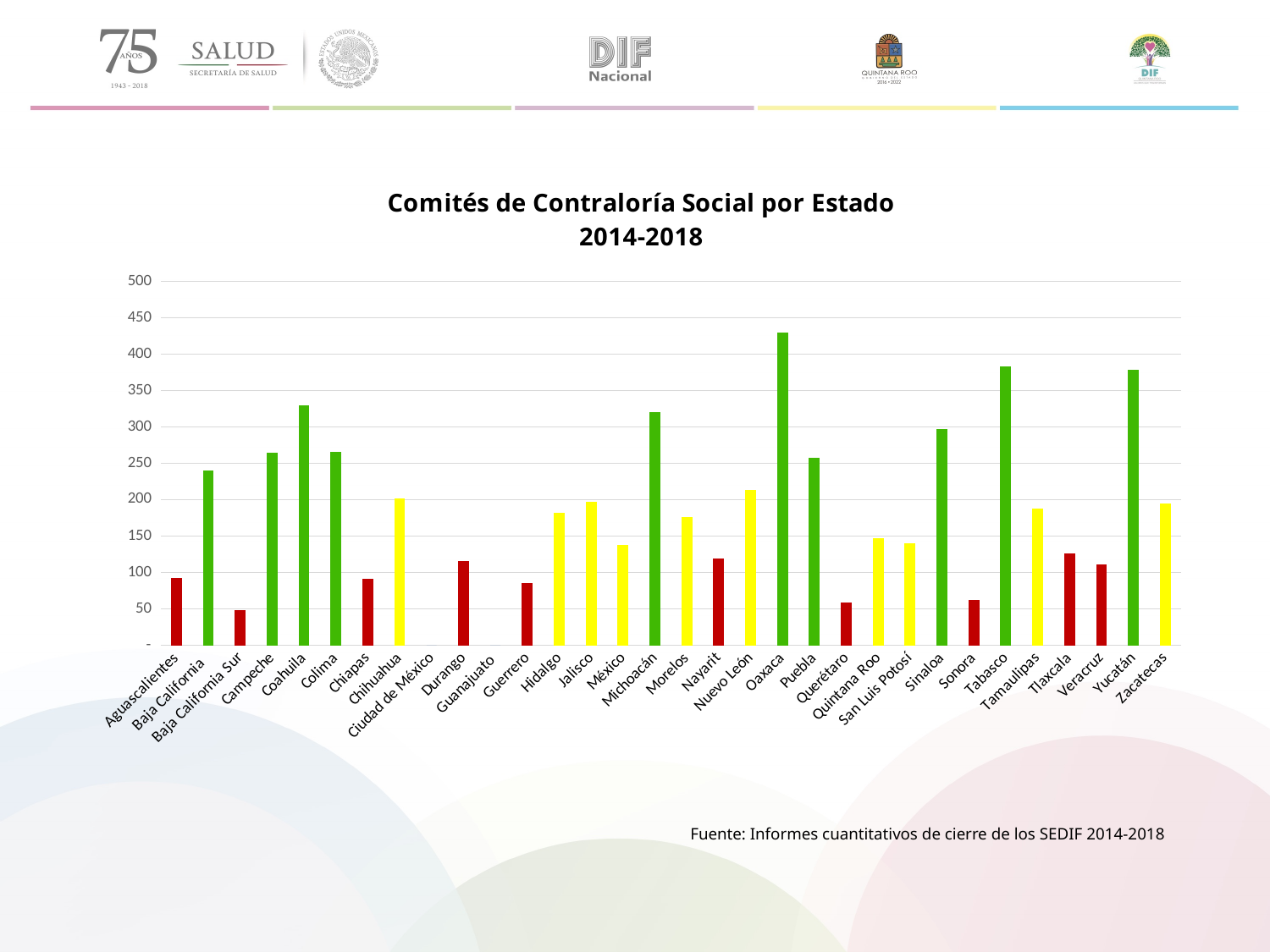
How many states are listed along the x axis of the chart? 32 Which state has the highest bar in the chart? Oaxaca What type of chart is shown on the slide? bar chart Is the value for Oaxaca greater or less than 400? greater Is the value for México greater or less than 150? less Is the value for Aguascalientes greater or less than 100? less Which has the larger value, Baja California or Campeche? Campeche What is the title of the chart? Comités de Contraloría Social por Estado 2014-2018 Which has the larger value, Coahuila or Colima? Coahuila